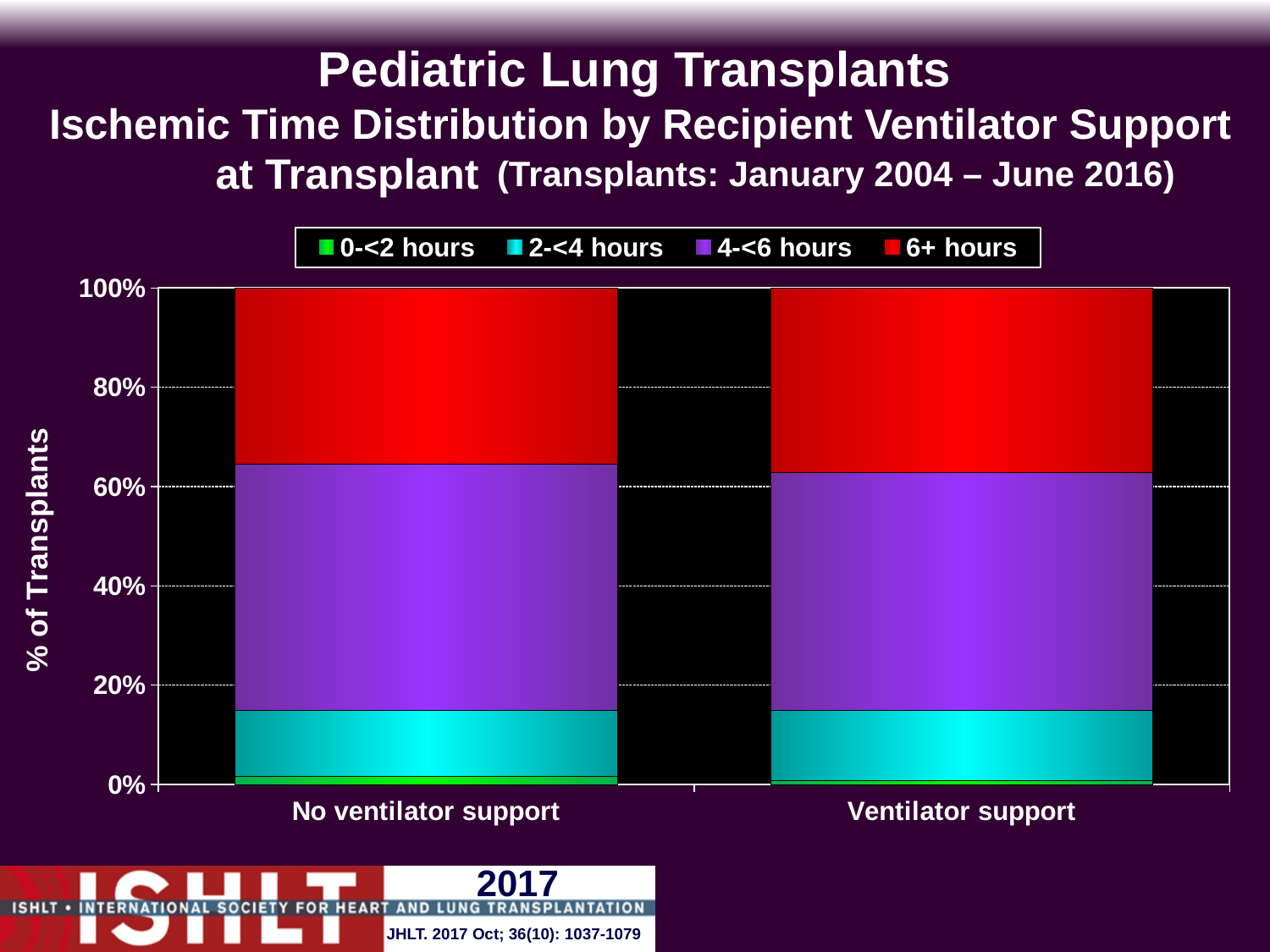
Is the 4-<6 hours segment for No ventilator support greater or less than 40%? greater Which ischemic time category makes up the largest share of the Ventilator support bar? 4-<6 hours Which colour represents the 6+ hours series in the legend? red Is the 0-<2 hours segment for No ventilator support greater or less than 20%? less Within the No ventilator support bar, which is larger: the 4-<6 hours segment or the 6+ hours segment? 4-<6 hours Is the 6+ hours segment for Ventilator support greater or less than 20%? greater How many series does the legend list? 4 What is the label of the y axis? % of Transplants What is the total height of the stacked bar for No ventilator support? 100% How many categories are shown on the x axis? 2 What kind of chart is shown on the slide? stacked bar chart